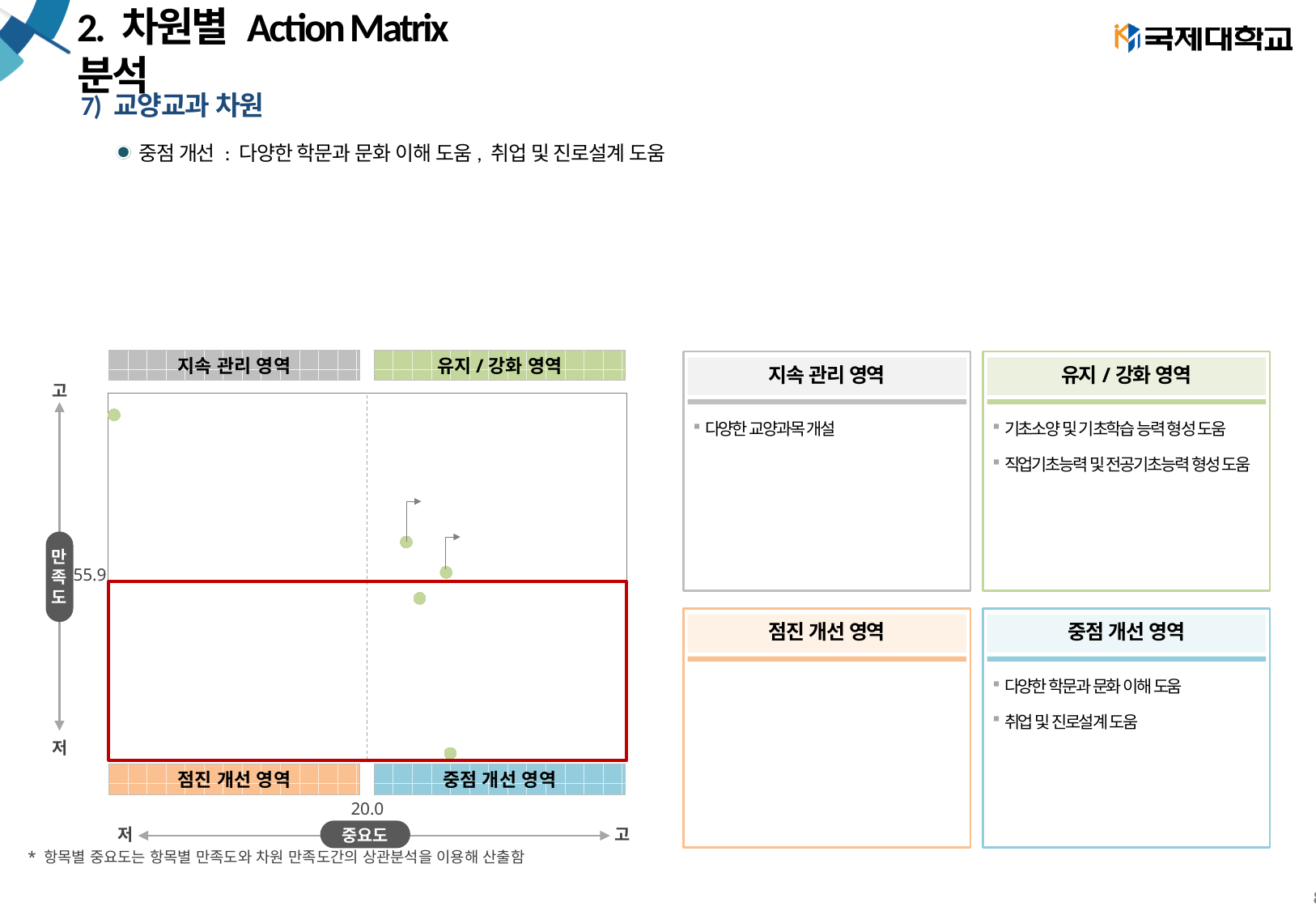
Which quadrant of the action matrix chart contains no data points? 점진 개선 영역 How many points fall in the 점진 개선 영역 quadrant of the action matrix chart? 0 How many data points are plotted in the action matrix chart? 5 In the action matrix chart, is the importance value of the lowest point greater or less than 20.0? greater How many points fall in the 중점 개선 영역 quadrant of the action matrix chart? 2 What is the label on the vertical axis of the action matrix chart? 만족도 What importance (중요도) value marks the vertical dividing line in the action matrix chart? 20.0 What is the label on the horizontal axis of the action matrix chart? 중요도 In the action matrix chart, is the satisfaction value of the point in the top-left quadrant greater or less than 55.9? greater What kind of chart is the action matrix on the left of the slide? scatter chart What satisfaction (만족도) value marks the horizontal dividing line in the action matrix chart? 55.9